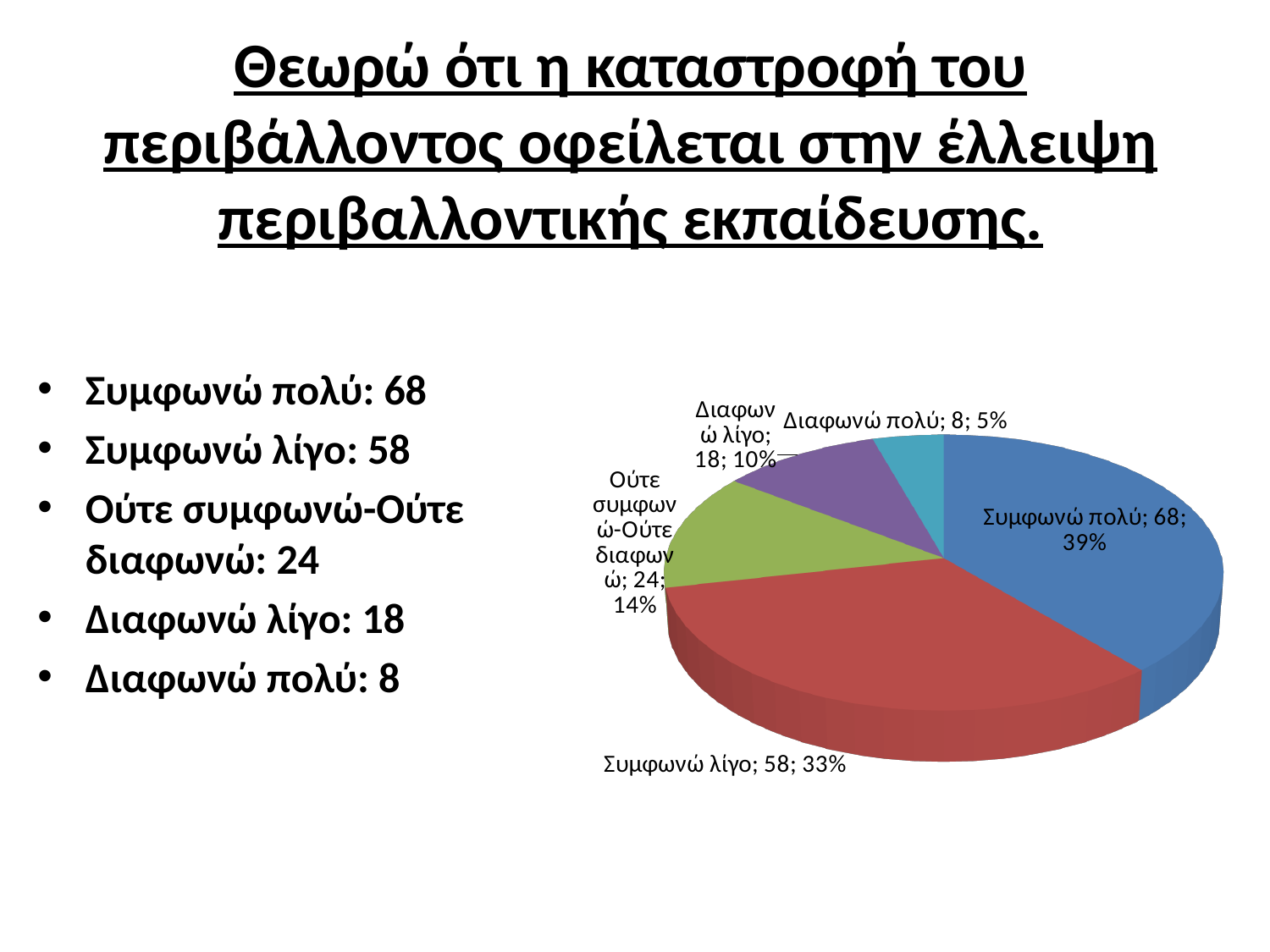
What is the value for Ούτε συμφωνώ-Ούτε διαφωνώ in the pie chart? 24 What is the value for Συμφωνώ πολύ in the pie chart? 68 What kind of chart is shown on the slide? pie chart Which category has the largest slice in the pie chart? Συμφωνώ πολύ What is the value for Διαφωνώ πολύ in the pie chart? 8 What share of the pie does Συμφωνώ λίγο represent? 33% How many slices does the pie chart have? 5 What is the difference between the values for Συμφωνώ πολύ and Συμφωνώ λίγο? 10 Which category has the smallest slice in the pie chart? Διαφωνώ πολύ What is the value for Συμφωνώ λίγο in the pie chart? 58 What share of the pie does Διαφωνώ λίγο represent? 10% Which is larger, the value for Ούτε συμφωνώ-Ούτε διαφωνώ or the value for Διαφωνώ λίγο? Ούτε συμφωνώ-Ούτε διαφωνώ